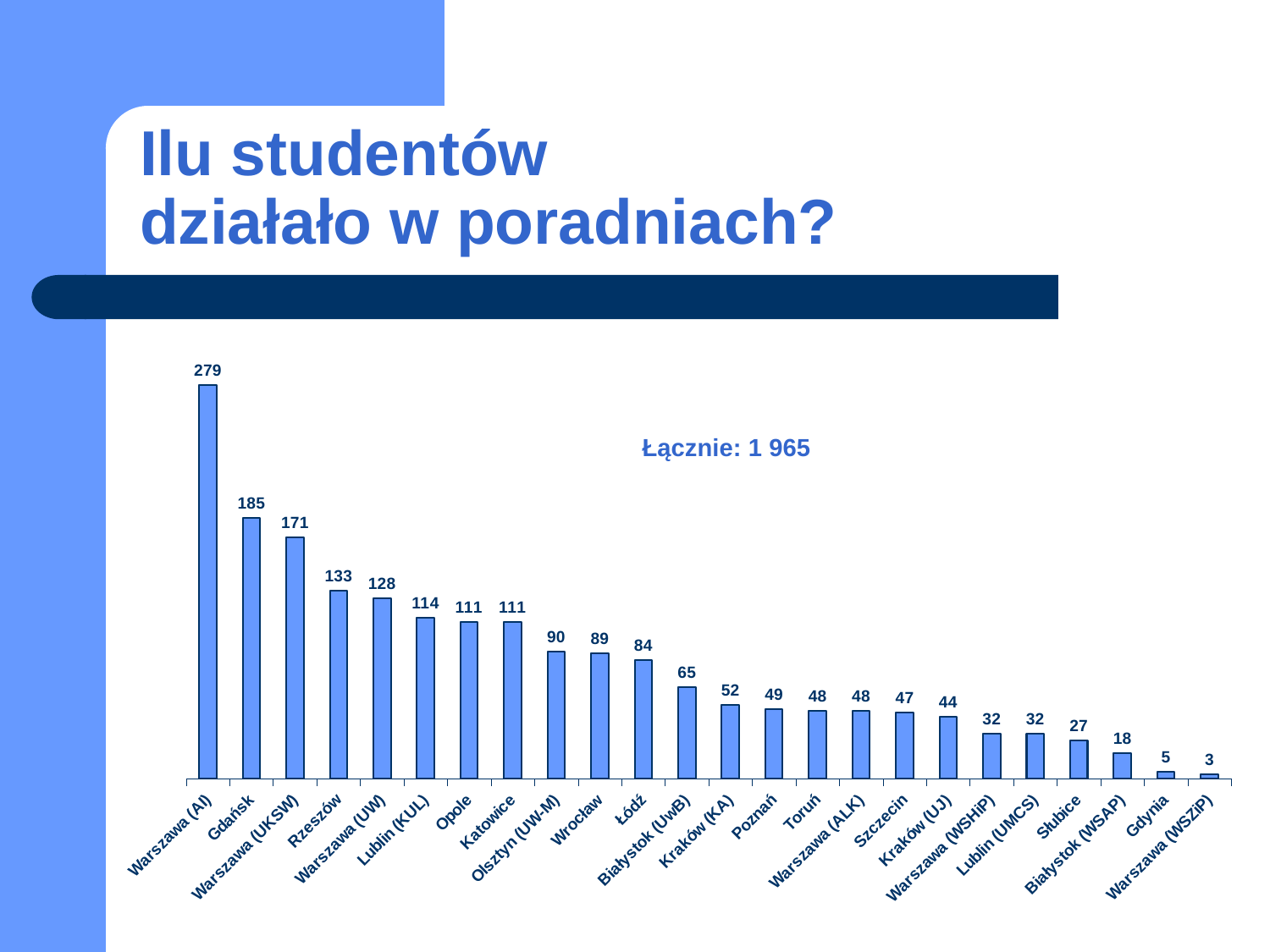
How many students are shown for Warszawa (AI)? 279 Which category has the highest value? Warszawa (AI) Do the values rise or fall from left to right along the x axis? Fall Which category has the lowest value? Warszawa (WSZiP) Which is larger, the value for Olsztyn (UW-M) or the value for Łódź? Olsztyn (UW-M) What is the difference between the values for Gdańsk and Warszawa (UKSW)? 14 What is the value for Rzeszów? 133 What is the value for Białystok (UwB)? 65 What is the value for Gdynia? 5 What total is stated on the chart after 'Łącznie'? 1 965 What kind of chart is shown on the slide? Bar chart How many categories are shown on the x axis? 24